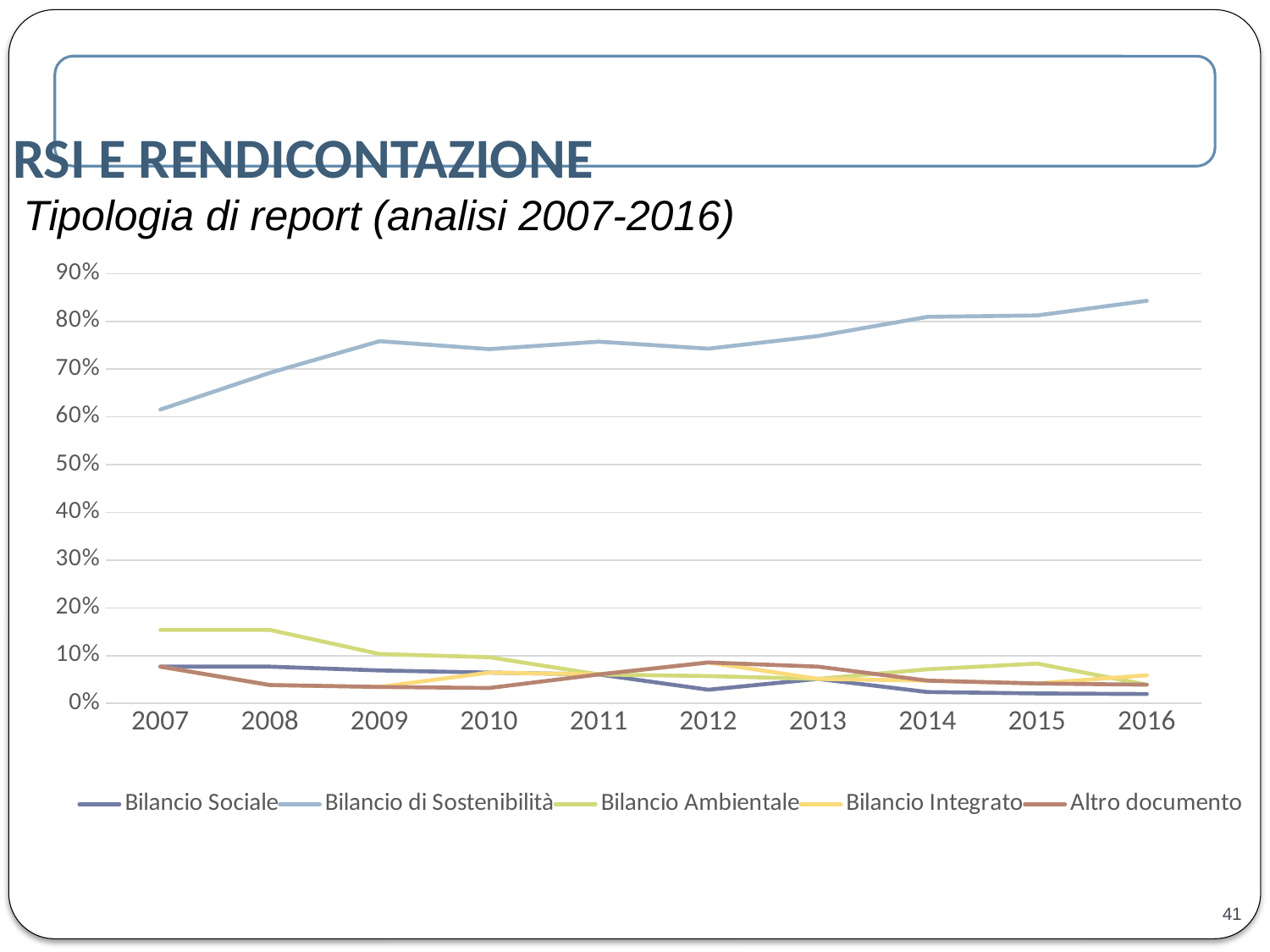
Which series is listed first in the legend? Bilancio Sociale How many series does the legend list? 5 Does the Bilancio di Sostenibilità line rise or fall from 2007 to 2016? rise In 2007, which is larger: Bilancio Ambientale or Bilancio Sociale? Bilancio Ambientale Is the value for Bilancio di Sostenibilità in 2016 greater or less than 80%? greater How many years are shown on the x axis? 10 Which series has the highest value in 2016? Bilancio di Sostenibilità Is the value for Bilancio di Sostenibilità in 2007 greater or less than 70%? less Which series has the lowest value in 2016? Bilancio Sociale Is the value for Bilancio Ambientale in 2007 greater or less than 10%? greater Does the Bilancio Ambientale line rise or fall from 2007 to 2009? fall What kind of chart is shown on the slide? line chart